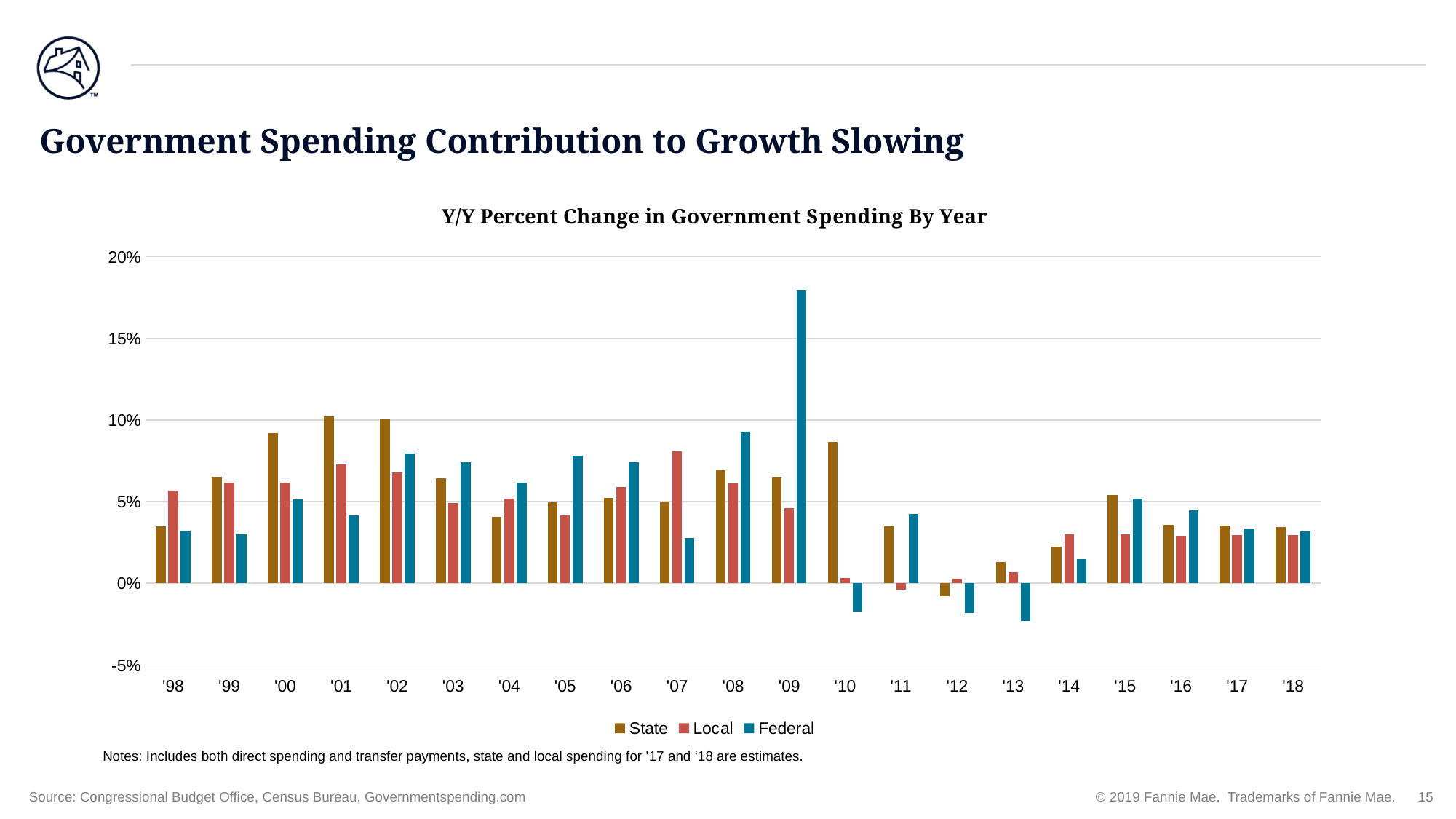
What kind of chart is shown on the slide? bar chart Which year has the highest Local value? '07 How many years are shown on the x axis? 21 How many series does the legend list? 3 Is the Federal value for '13 greater or less than 0%? less Is the State value for '10 greater or less than 5%? greater In '98, which is larger, the State value or the Local value? Local Which year has the lowest Federal value? '13 Which year has the highest Federal value? '09 In '07, which is larger, the Local value or the Federal value? Local Is the Federal value for '09 greater or less than 15%? greater Does the State value rise or fall from '10 to '12? fall